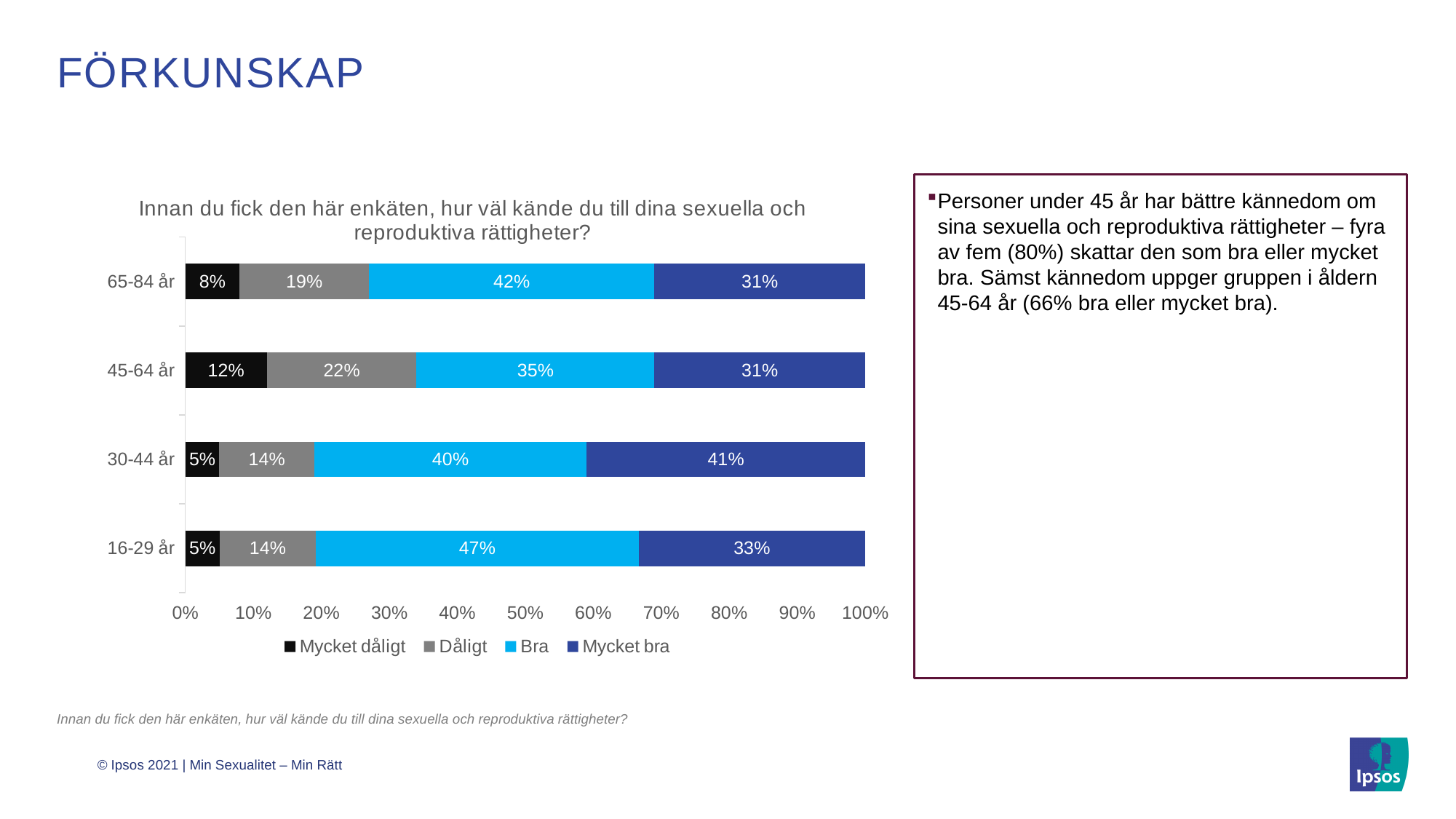
What is the "Mycket bra" value for the 65-84 år group? 31% What is the total of the labelled segments for the 16-29 år bar? 99% What percentage of the 16-29 år group answered "Bra"? 47% Which group has a larger "Bra" share, 65-84 år or 30-44 år? 65-84 år How much larger is the "Dåligt" share for 45-64 år than for 16-29 år? 8% Which age group has the lowest "Bra" share? 45-64 år How many series does the legend list? 4 What type of chart is shown on the slide? Stacked bar chart How many age groups are shown in the chart? 4 What is the "Mycket dåligt" value for the 45-64 år group? 12% Which age group has the highest "Mycket bra" share? 30-44 år Which legend entry is shown in black? Mycket dåligt